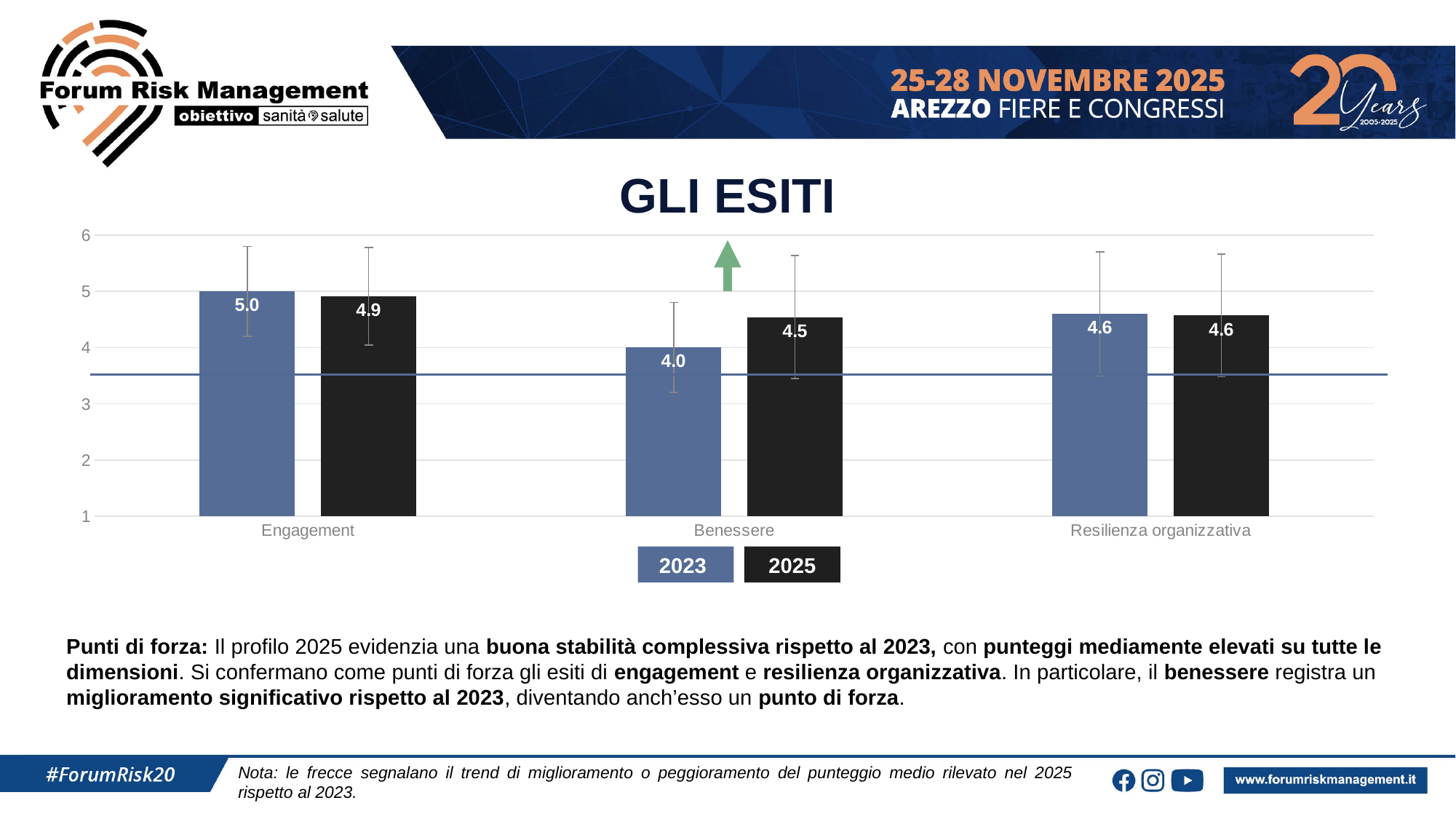
What is the difference between the 2025 and 2023 values for Benessere? 0.5 For Engagement, which is larger: the 2023 value or the 2025 value? 2023 What is the 2025 value for Benessere? 4.5 How many series does the legend list? 2 What is the 2025 value for Engagement? 4.9 What is the title of the chart? GLI ESITI What is the 2023 value for Engagement? 5.0 What is the 2023 value for Resilienza organizzativa? 4.6 Which category has the lowest 2023 value? Benessere What kind of chart is shown on the slide? Bar chart How many categories are shown on the x axis? 3 Which category has the highest 2025 value? Engagement